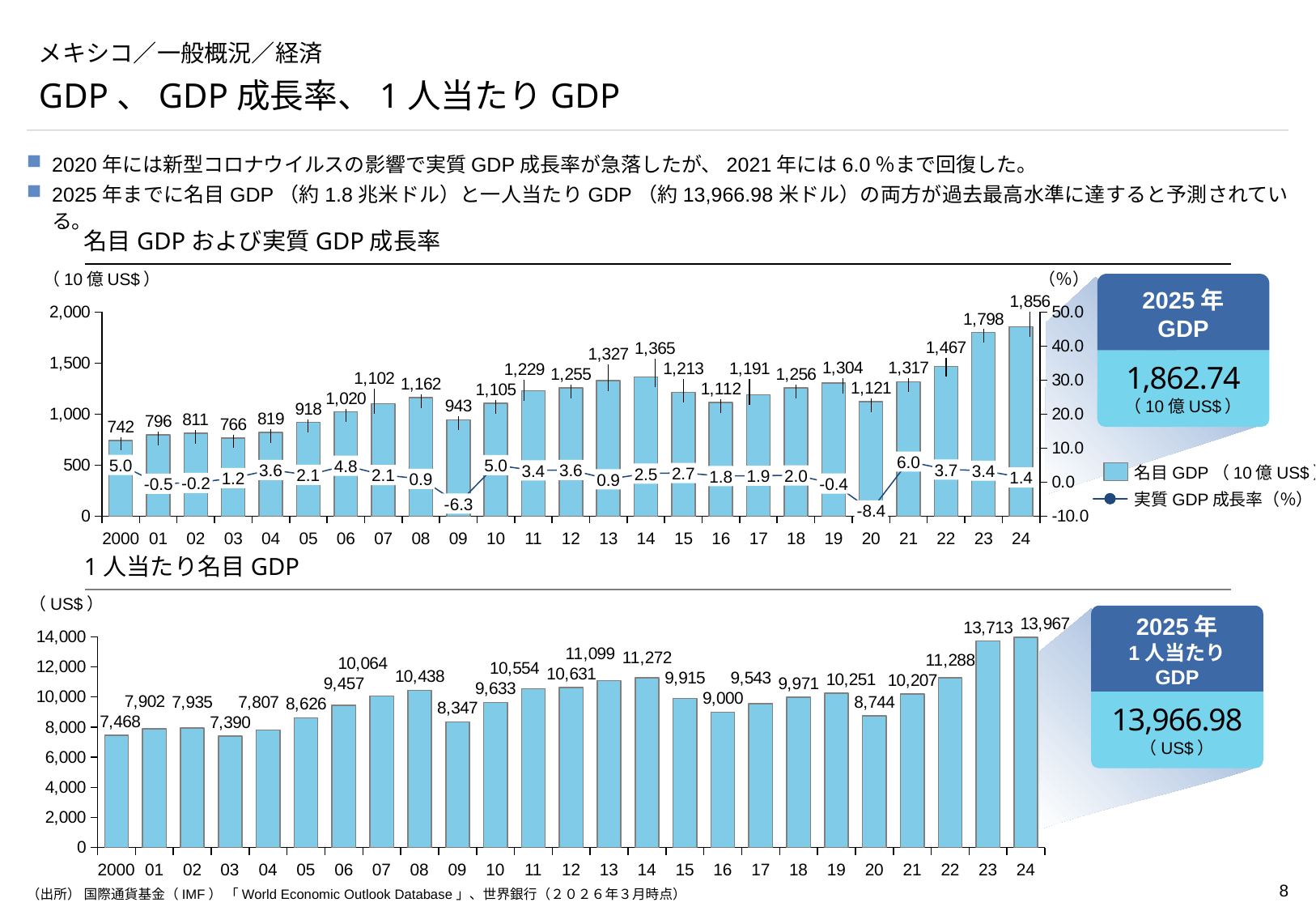
In the top chart (名目GDPおよび実質GDP成長率), which year has the lowest real GDP growth rate? 20 In the bottom chart (1人当たり名目GDP), which year has the highest value? 24 In the top chart (名目GDPおよび実質GDP成長率), what is the difference in nominal GDP between 2024 and 2023? 58 In the bottom chart (1人当たり名目GDP), which year has the lowest value? 03 In the bottom chart (1人当たり名目GDP), how many years are plotted? 25 In the bottom chart (1人当たり名目GDP), what is the value for 2009? 8,347 In the top chart (名目GDPおよび実質GDP成長率), how many series does the legend list? 2 In the top chart (名目GDPおよび実質GDP成長率), what is the real GDP growth rate for 2020? -8.4 In the bottom chart (1人当たり名目GDP), what is the difference between the values for 2023 and 2020? 4,969 What type of chart is the bottom chart (1人当たり名目GDP)? Bar chart In the top chart (名目GDPおよび実質GDP成長率), what is the nominal GDP value for 2024? 1,856 In the top chart (名目GDPおよび実質GDP成長率), which is larger, the nominal GDP for 2014 or for 2015? 2014